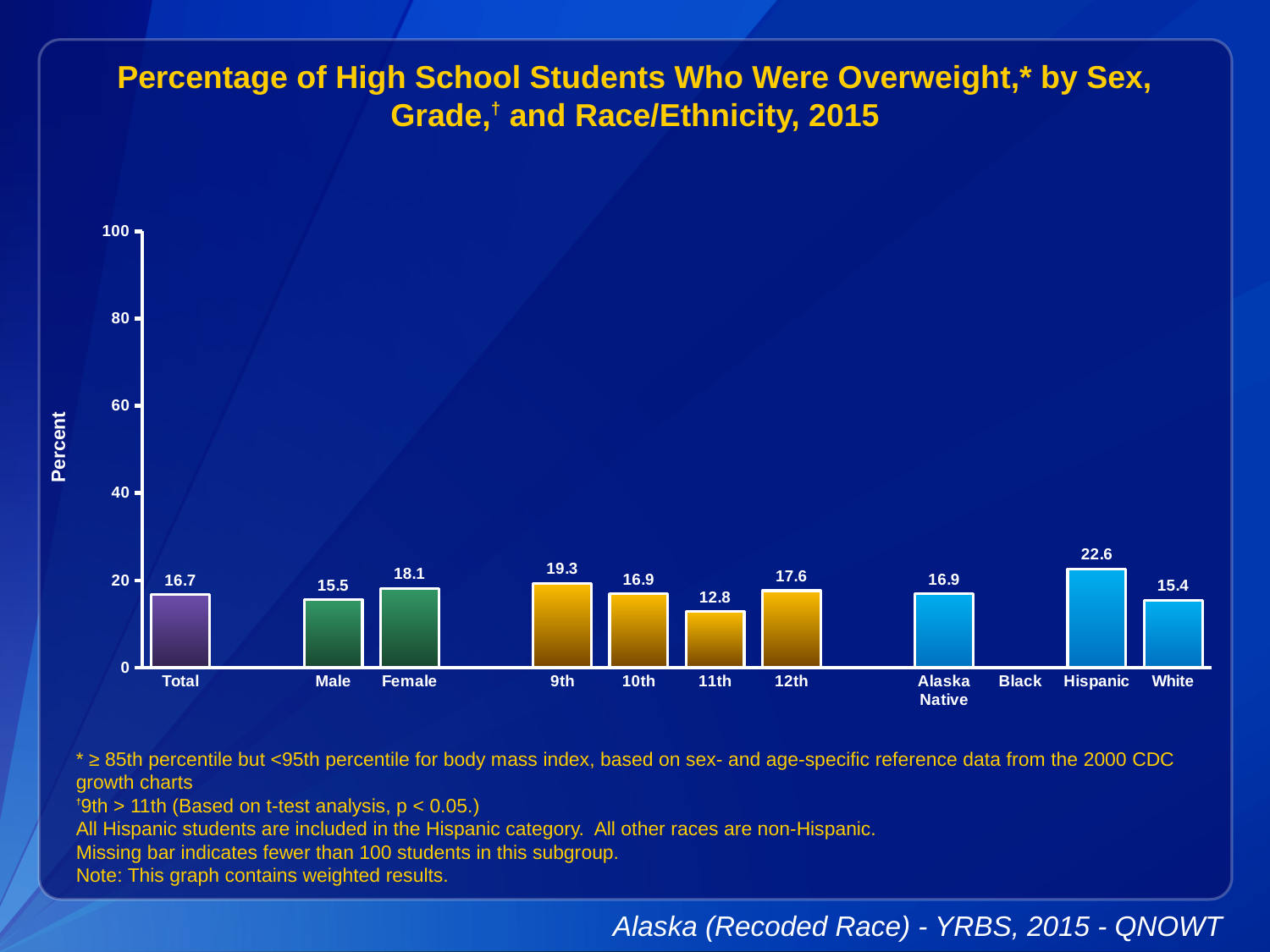
What is the value for Female? 18.1 Which is larger, the value for 9th grade or the value for 12th grade? 9th What kind of chart is shown? bar chart How many bars are plotted on the chart? 10 Which category has the highest value? Hispanic Which category has the lowest value among the bars shown? 11th Which category on the x axis has no bar plotted? Black What is the difference between the Female and Male values? 2.6 What is the value for 11th grade? 12.8 Is the value for Hispanic greater or less than 20? greater What is the value for Hispanic? 22.6 What is the value for Total? 16.7